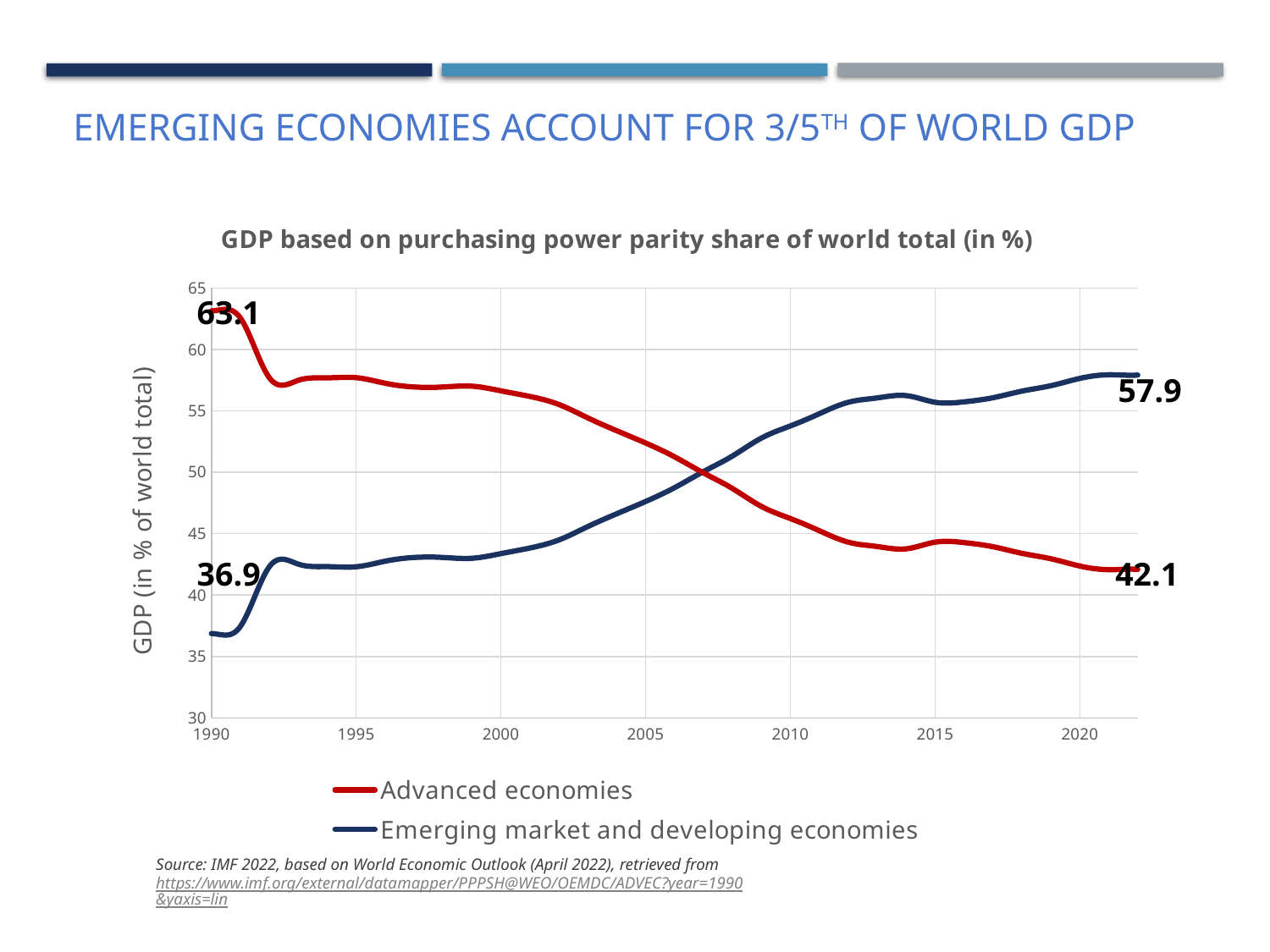
Does the Advanced economies line rise or fall from 1990 to the end of the chart? fall What is the title of the chart? GDP based on purchasing power parity share of world total (in %) What is the value for Advanced economies in 1990? 63.1 What is the difference between the 1990 values of Advanced economies and Emerging market and developing economies? 26.2 What is the final labelled value for Advanced economies at the right end of the chart? 42.1 Which series has the higher value in 1990, Advanced economies or Emerging market and developing economies? Advanced economies By how much did the Advanced economies value fall from its 1990 value to its final labelled value? 21 How many series does the legend list? 2 Is the value for Emerging market and developing economies in 2010 greater or less than 50? greater What is the value for Emerging market and developing economies in 1990? 36.9 What kind of chart is shown on the slide? line chart What is the final labelled value for Emerging market and developing economies at the right end of the chart? 57.9